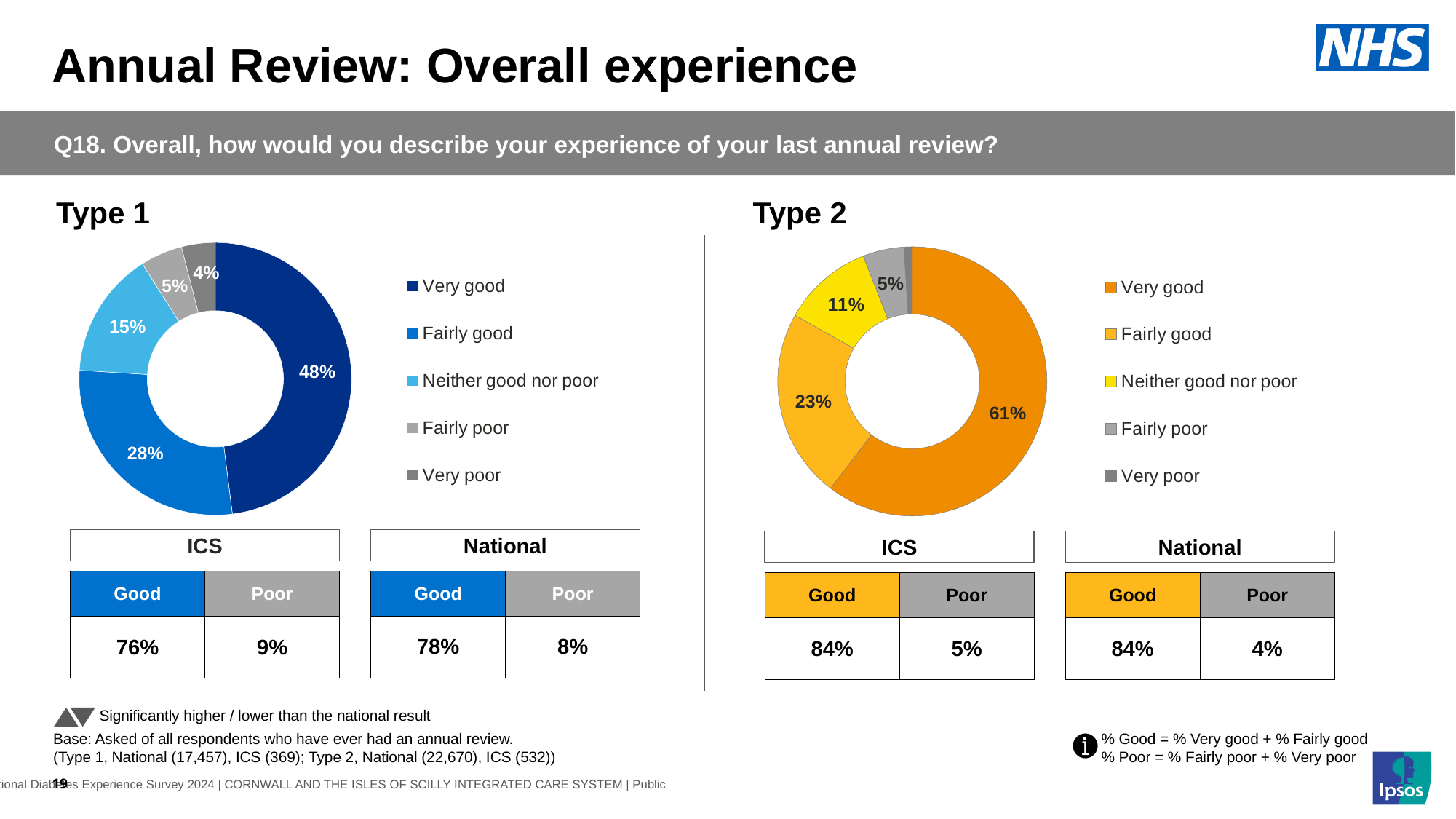
In the Type 2 chart, what colour represents 'Neither good nor poor'? Yellow In the Type 1 chart, what percentage of respondents said their experience was 'Very good'? 48% In the Type 2 chart, what is the difference between the 'Very good' and 'Fairly good' percentages? 38% In the Type 1 chart, what percentage is shown for 'Neither good nor poor'? 15% Which chart shows a larger 'Very good' share, Type 1 or Type 2? Type 2 In the Type 2 chart, what percentage of respondents said their experience was 'Fairly good'? 23% In the Type 2 chart, what percentage is shown for 'Very good'? 61% What kind of chart is used for Type 1? Donut (pie) chart In the Type 1 chart, what is the difference between the 'Fairly good' and 'Neither good nor poor' percentages? 13% In the Type 1 chart, which labelled category has the smallest share? Very poor How many categories does the legend of the Type 1 chart list? 5 In the Type 1 chart, which category has the largest share? Very good